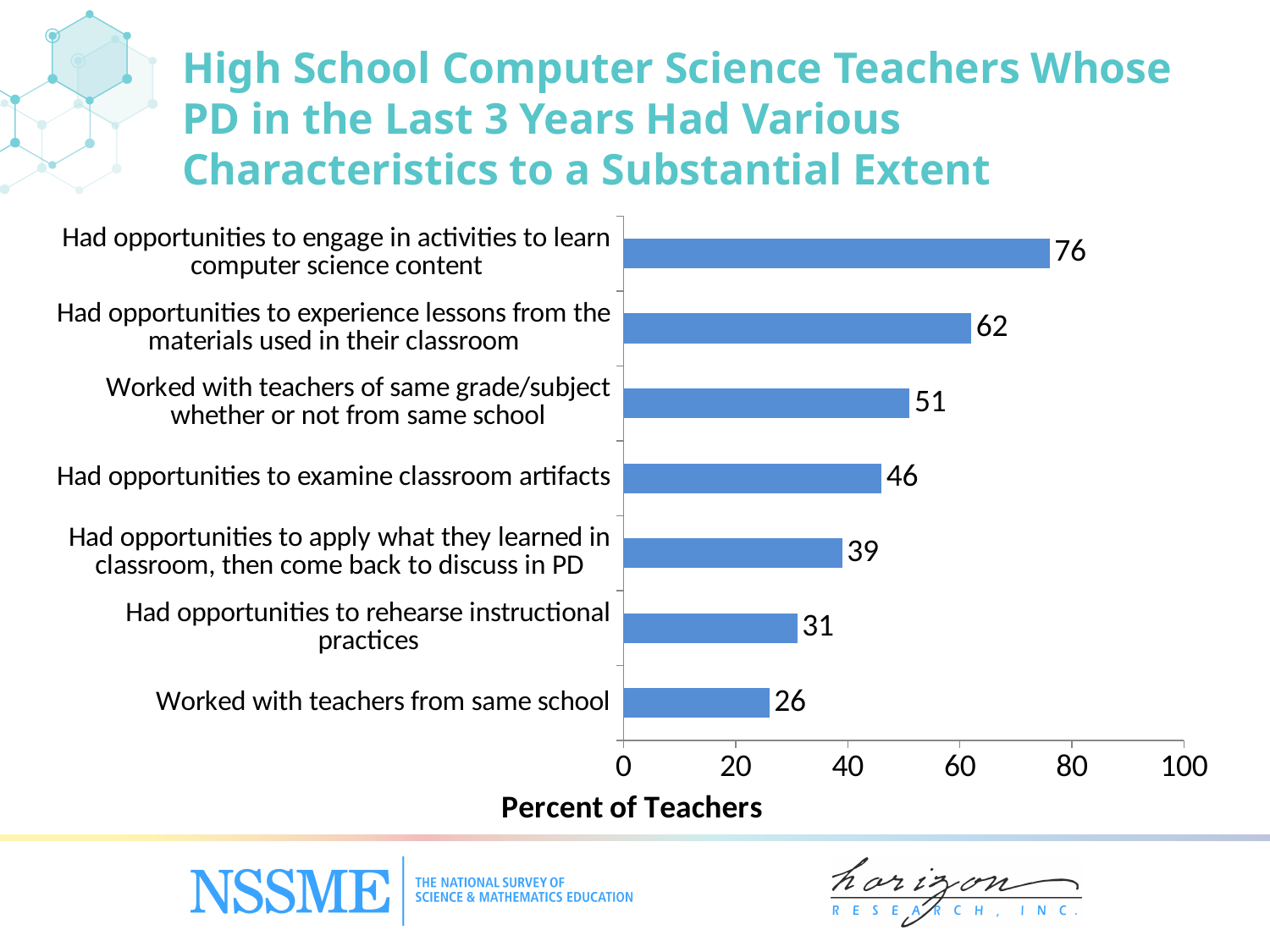
How many PD characteristics are shown in the chart? 7 What percent of teachers had opportunities to examine classroom artifacts? 46 What is the value for 'Had opportunities to rehearse instructional practices'? 31 Which PD characteristic has the highest percent of teachers? Had opportunities to engage in activities to learn computer science content Is the value for 'Had opportunities to examine classroom artifacts' greater or less than 40? greater Which is larger: the value for 'Had opportunities to apply what they learned in classroom, then come back to discuss in PD' or the value for 'Had opportunities to rehearse instructional practices'? Had opportunities to apply what they learned in classroom, then come back to discuss in PD What percent of teachers had opportunities to engage in activities to learn computer science content? 76 Which PD characteristic has the lowest percent of teachers? Worked with teachers from same school What is the label of the horizontal axis? Percent of Teachers What kind of chart is shown on the slide? Bar chart What is the value for 'Worked with teachers from same school'? 26 What is the difference between the values for 'Had opportunities to experience lessons from the materials used in their classroom' and 'Worked with teachers of same grade/subject whether or not from same school'? 11